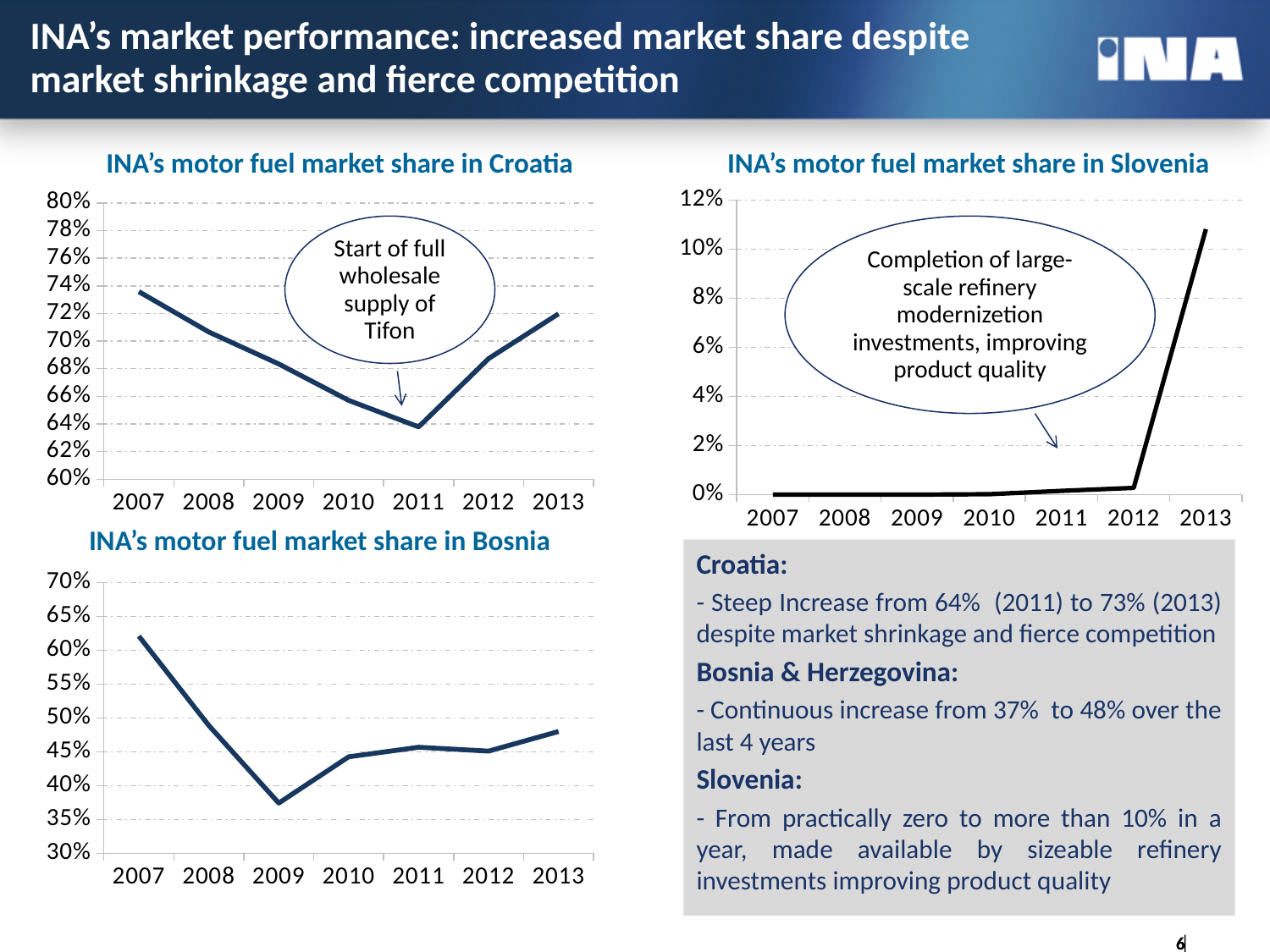
In the 'INA's motor fuel market share in Slovenia' chart, is the value for 2013 greater or less than 10%? greater In the 'INA's motor fuel market share in Bosnia' chart, is the value for 2009 greater or less than 40%? less In the 'INA's motor fuel market share in Croatia' chart, is the value for 2007 greater or less than 72%? greater In the 'INA's motor fuel market share in Bosnia' chart, which year has the highest market share? 2007 In the 'INA's motor fuel market share in Croatia' chart, which year has the lowest market share? 2011 What type of chart is 'INA's motor fuel market share in Croatia'? line chart In the 'INA's motor fuel market share in Slovenia' chart, which year has the highest market share? 2013 In the 'INA's motor fuel market share in Croatia' chart, does the market share rise or fall from 2011 to 2013? rise In the 'INA's motor fuel market share in Bosnia' chart, which year has the lowest market share? 2009 How many years are plotted in the 'INA's motor fuel market share in Bosnia' chart? 7 In the 'INA's motor fuel market share in Bosnia' chart, does the market share rise or fall from 2007 to 2009? fall